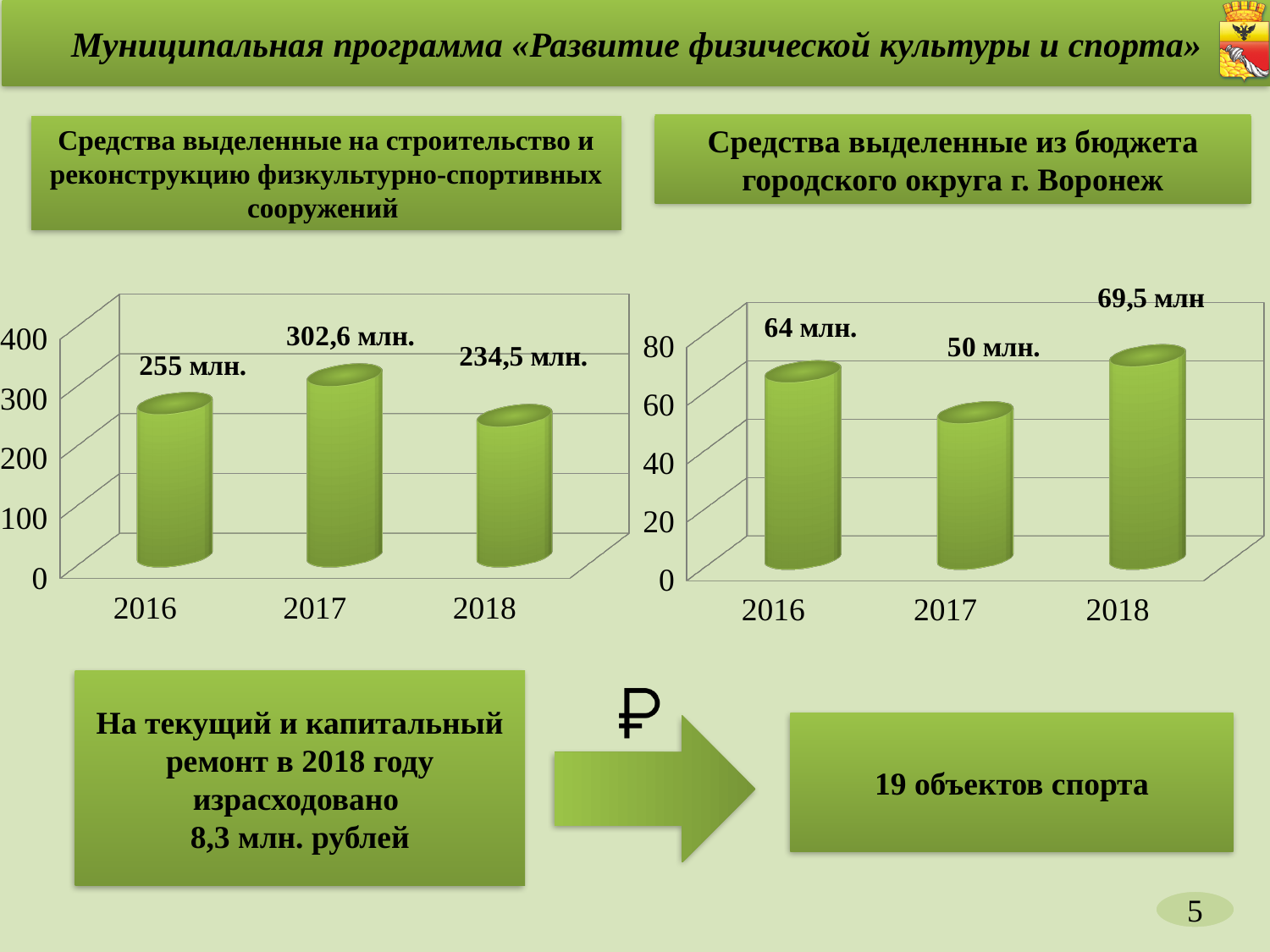
In the right chart, is the value for 2016 greater or less than 60? greater In the left chart, which year has the lowest value? 2018 In the right chart, which year has the lowest value? 2017 In the right chart (funds from the Voronezh city budget), what value is shown for 2018? 69,5 млн In the right chart (funds from the Voronezh city budget), what value is shown for 2016? 64 млн. In the left chart, which year has the highest value? 2017 In the left chart (construction and reconstruction of sports facilities), what value is shown for 2017? 302,6 млн. What type of chart is the left chart? Bar chart In the left chart (construction and reconstruction of sports facilities), what value is shown for 2018? 234,5 млн. In the right chart, what is the difference between the 2018 and 2017 values? 19,5 млн. In the left chart, what is the difference between the 2017 and 2016 values? 47,6 млн. In the right chart, which year has the highest value? 2018